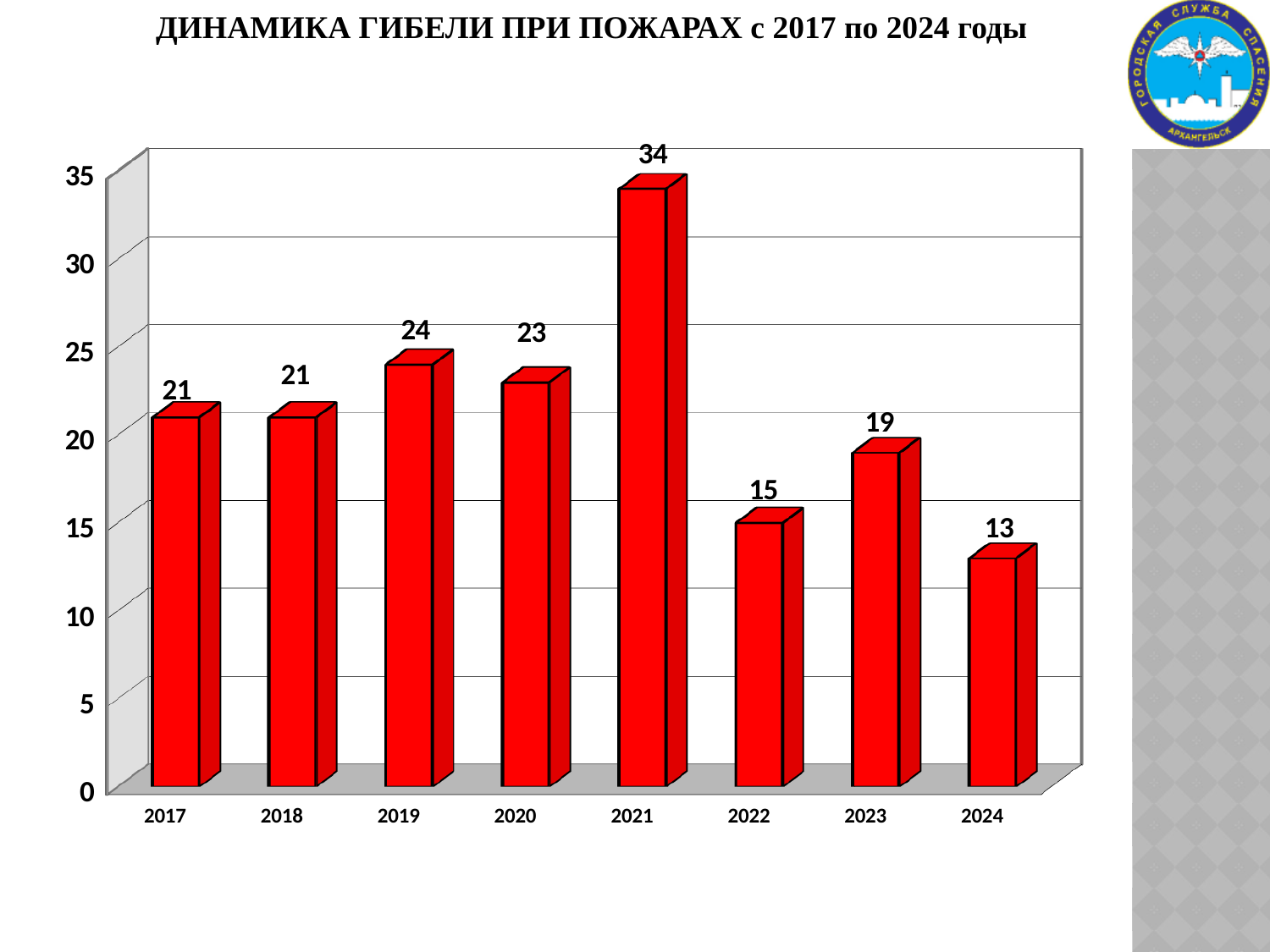
What is the title of the chart? ДИНАМИКА ГИБЕЛИ ПРИ ПОЖАРАХ с 2017 по 2024 годы What kind of chart is shown on the slide? bar chart What is the value for 2021? 34 What is the value for 2024? 13 How many years are shown on the x axis? 8 Is the value for 2021 greater or less than 30? greater What is the value for 2019? 24 What is the difference between the values for 2021 and 2022? 19 Which is larger, the value for 2023 or the value for 2022? 2023 What is the difference between the values for 2019 and 2020? 1 Which year has the lowest value? 2024 Which year has the highest value? 2021